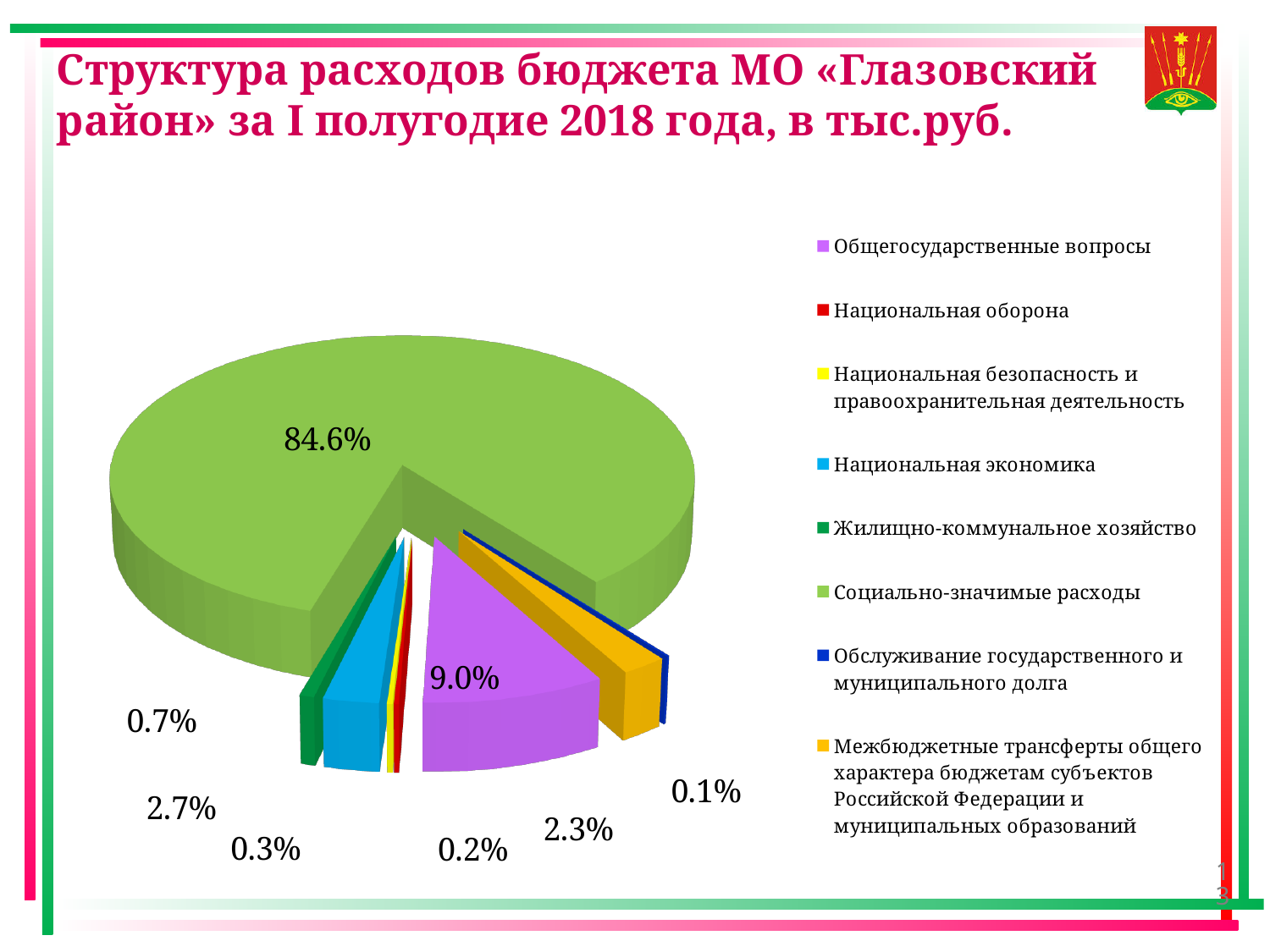
Which is larger: the share for "Национальная экономика" or the share for "Общегосударственные вопросы"? Общегосударственные вопросы What kind of chart is shown on the slide? pie chart What is the value shown for "Межбюджетные трансферты общего характера бюджетам субъектов Российской Федерации и муниципальных образований"? 2.3% Which category has the smallest share of the pie? Обслуживание государственного и муниципального долга Which category has the largest share of the pie? Социально-значимые расходы What is the value shown for "Национальная экономика"? 2.7% What colour is the slice for "Общегосударственные вопросы"? purple How many categories does the legend of the pie chart list? 8 What share of the pie does "Социально-значимые расходы" take? 84.6% What is the difference in percentage points between "Социально-значимые расходы" and "Общегосударственные вопросы"? 75.6 What is the value shown for "Общегосударственные вопросы"? 9.0% What is the title of the slide containing the pie chart? Структура расходов бюджета МО «Глазовский район» за I полугодие 2018 года, в тыс.руб.